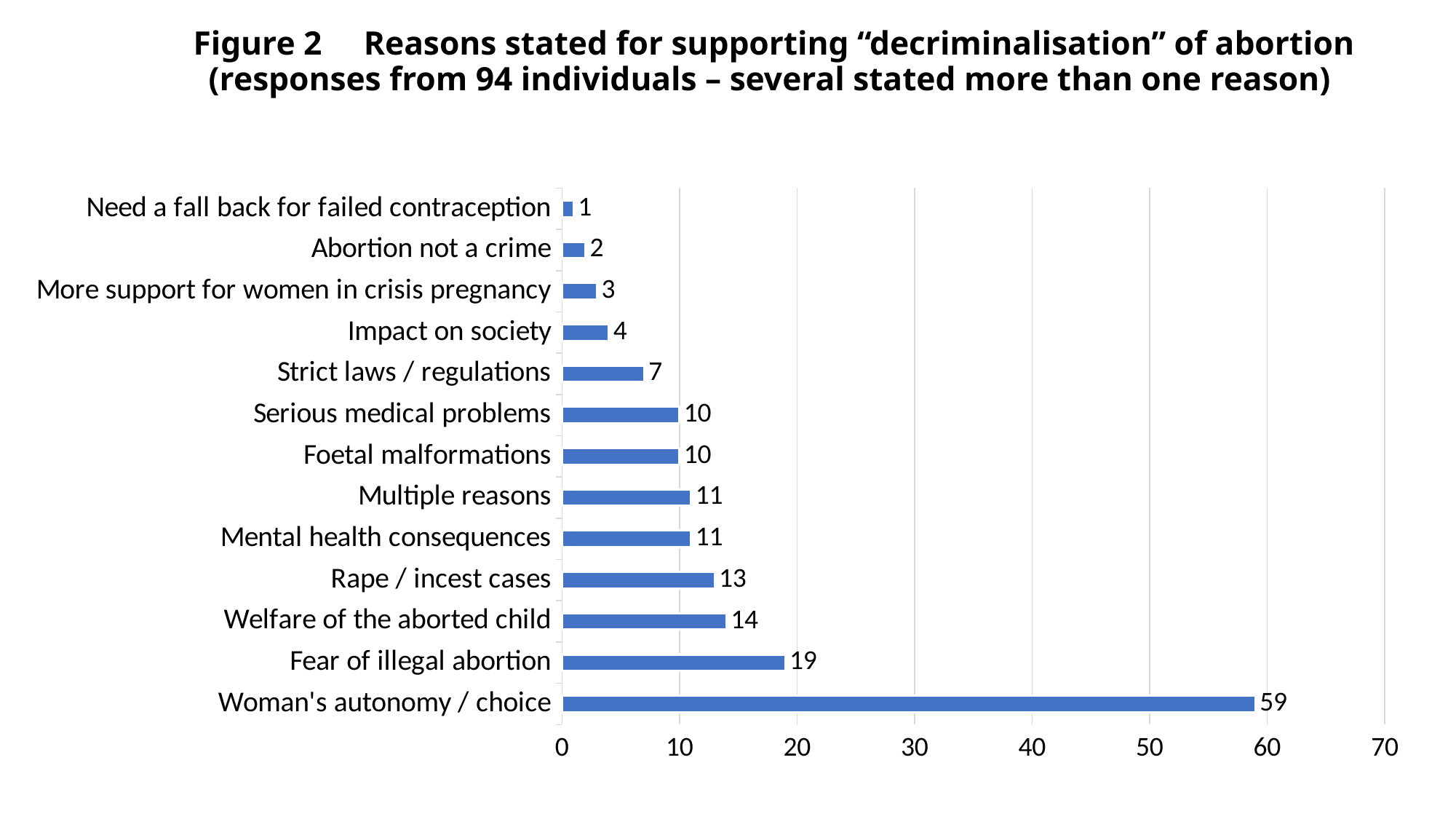
How many reasons (categories) are shown in the chart? 13 What value is shown for Strict laws / regulations? 7 What is the difference between the values for Woman's autonomy / choice and Fear of illegal abortion? 40 What value is shown for Fear of illegal abortion? 19 What value is shown for Rape / incest cases? 13 What value is shown for Woman's autonomy / choice? 59 What kind of chart is shown on the slide? Bar chart What is the difference between the values for Welfare of the aborted child and Impact on society? 10 Which reason has the highest value? Woman's autonomy / choice Which reason has the lowest value? Need a fall back for failed contraception Is the value for Woman's autonomy / choice greater or less than 50? greater Which is larger, the value for Rape / incest cases or the value for Mental health consequences? Rape / incest cases